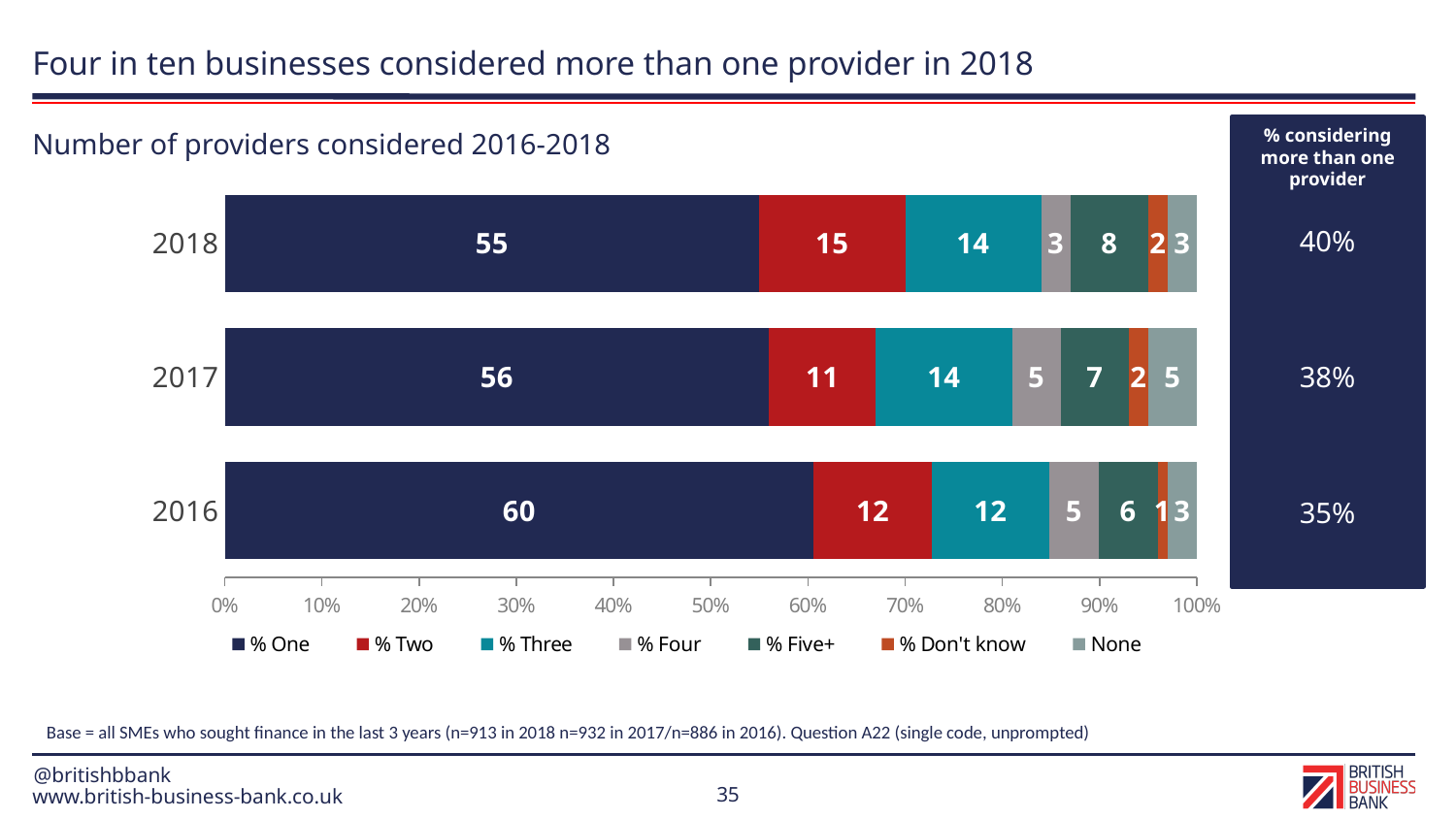
What is the total of the stacked bar for 2016? 99 What is the difference between the % One values for 2016 and 2018? 5 What is the value for % Four in 2018? 3 How many series does the legend list? 7 What is the value for % Two in 2017? 11 Is the % Two value larger in 2018 or in 2016? 2018 What is the value for % Five+ in 2016? 6 What is the value for % One in 2018? 55 How many years (categories) are shown in the chart? 3 What kind of chart is shown on the slide? Stacked bar chart Which year has the lowest value for % Two? 2017 Which year has the highest value for % One? 2016